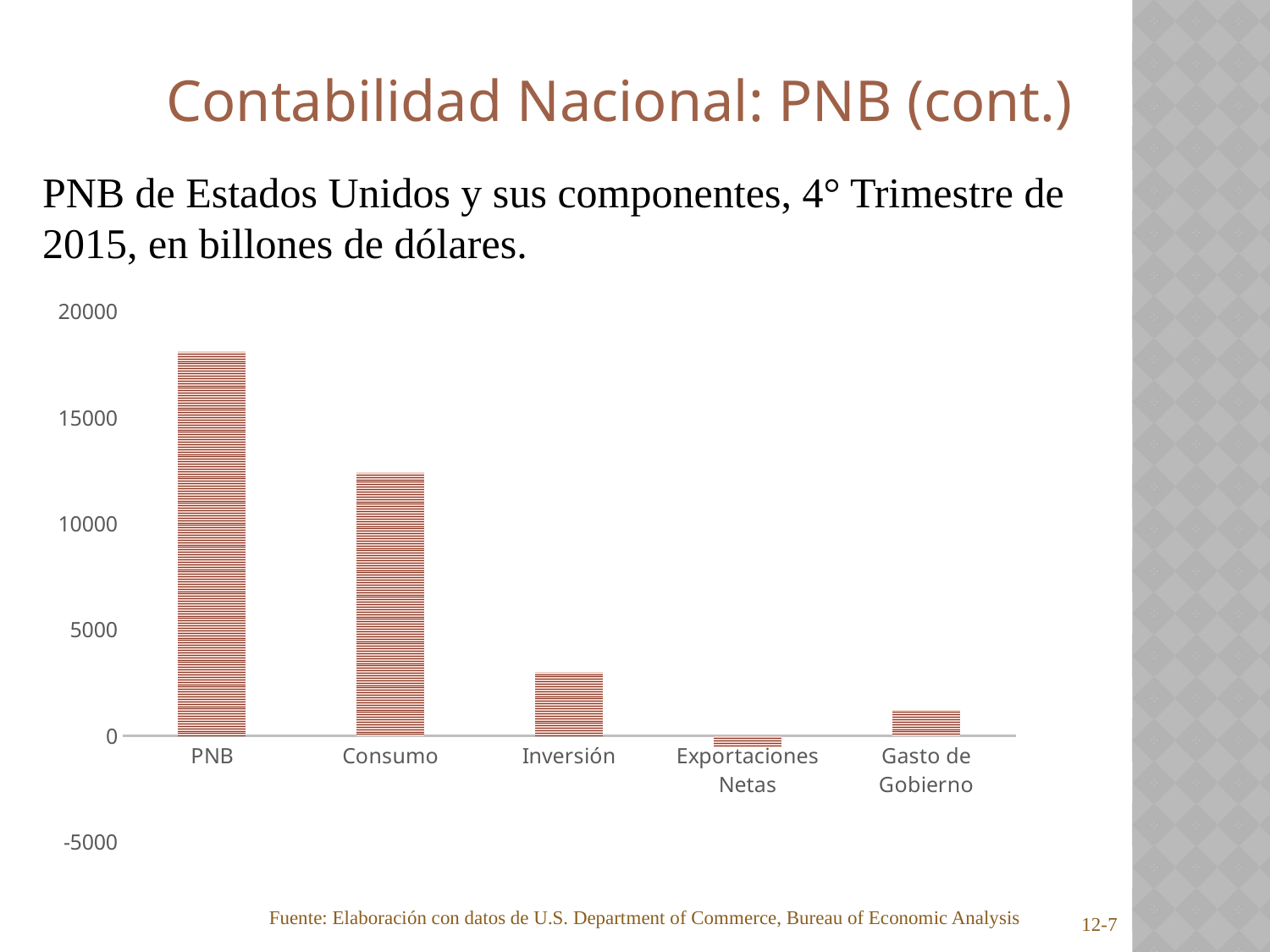
How many categories are plotted on the x axis of the chart? 5 What kind of chart is shown on the slide? bar chart Which category has the highest value in the chart? PNB Which is larger, the value for Consumo or the value for Inversión? Consumo Which is larger, the value for Inversión or the value for Gasto de Gobierno? Inversión Is the value for Consumo greater or less than 10000? greater What is the lowest tick value shown on the vertical axis of the chart? -5000 Is the value for Gasto de Gobierno greater or less than 5000? less Is the value for Exportaciones Netas greater or less than 0? less Which category has the lowest value in the chart? Exportaciones Netas